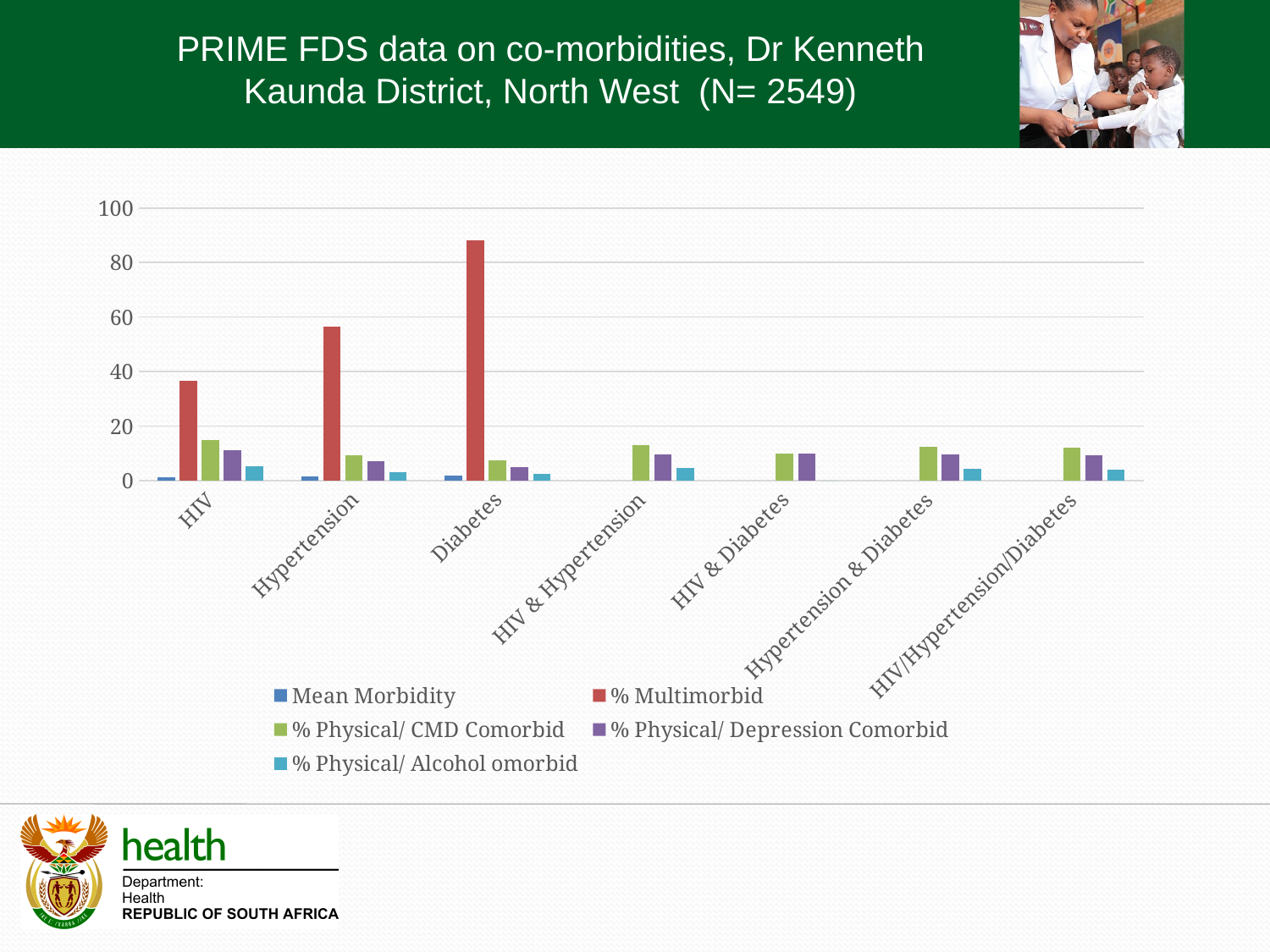
Is the % Multimorbid value for Diabetes greater or less than 80? greater How many series does the chart's legend list? 5 Is the % Physical/ CMD Comorbid value for HIV greater or less than 20? less How many categories are shown along the x axis of the chart? 7 Is the % Multimorbid value for HIV greater or less than 40? less What kind of chart is shown on the slide? bar chart Which is larger, the % Multimorbid value for Hypertension or for HIV? Hypertension Which category has the highest % Multimorbid value? Diabetes What sample size (N) is given in the slide title? N= 2549 Which series is shown in red in the chart's legend? % Multimorbid Does the % Multimorbid value rise or fall across HIV, Hypertension and Diabetes? rise